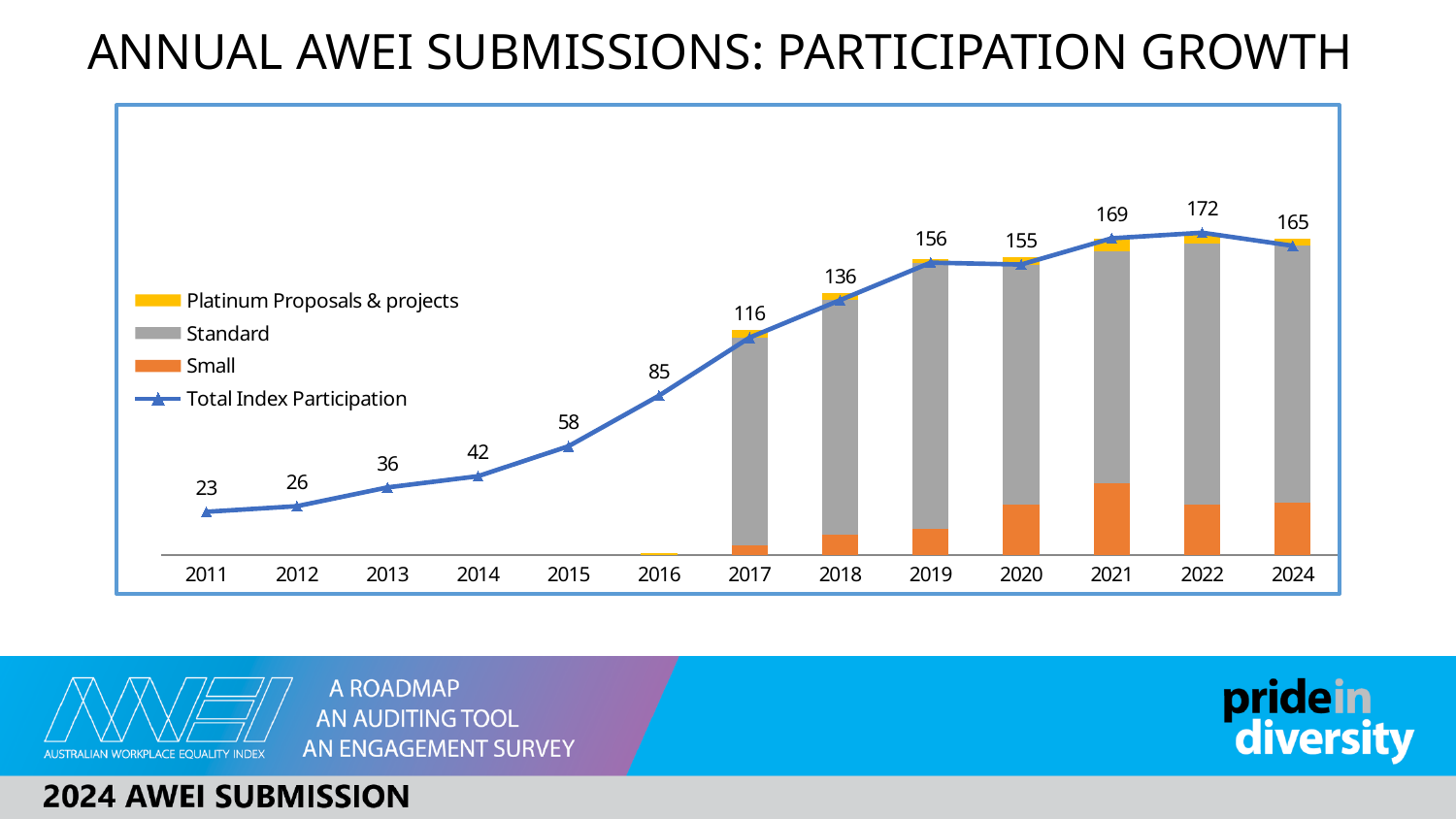
Which year has the higher Total Index Participation, 2019 or 2020? 2019 How many series does the legend list? 4 Which year has the highest Total Index Participation? 2022 What is the Total Index Participation value for 2016? 85 Which year has the lowest Total Index Participation? 2011 What is the Total Index Participation value for 2017? 116 Does Total Index Participation generally rise or fall from 2011 to 2022? Rise What is the Total Index Participation value for 2024? 165 What is the difference in Total Index Participation between 2022 and 2024? 7 How many years are shown on the x axis? 13 What kind of chart is this? A combined stacked bar and line chart By how much did Total Index Participation increase from 2011 to 2021? 146